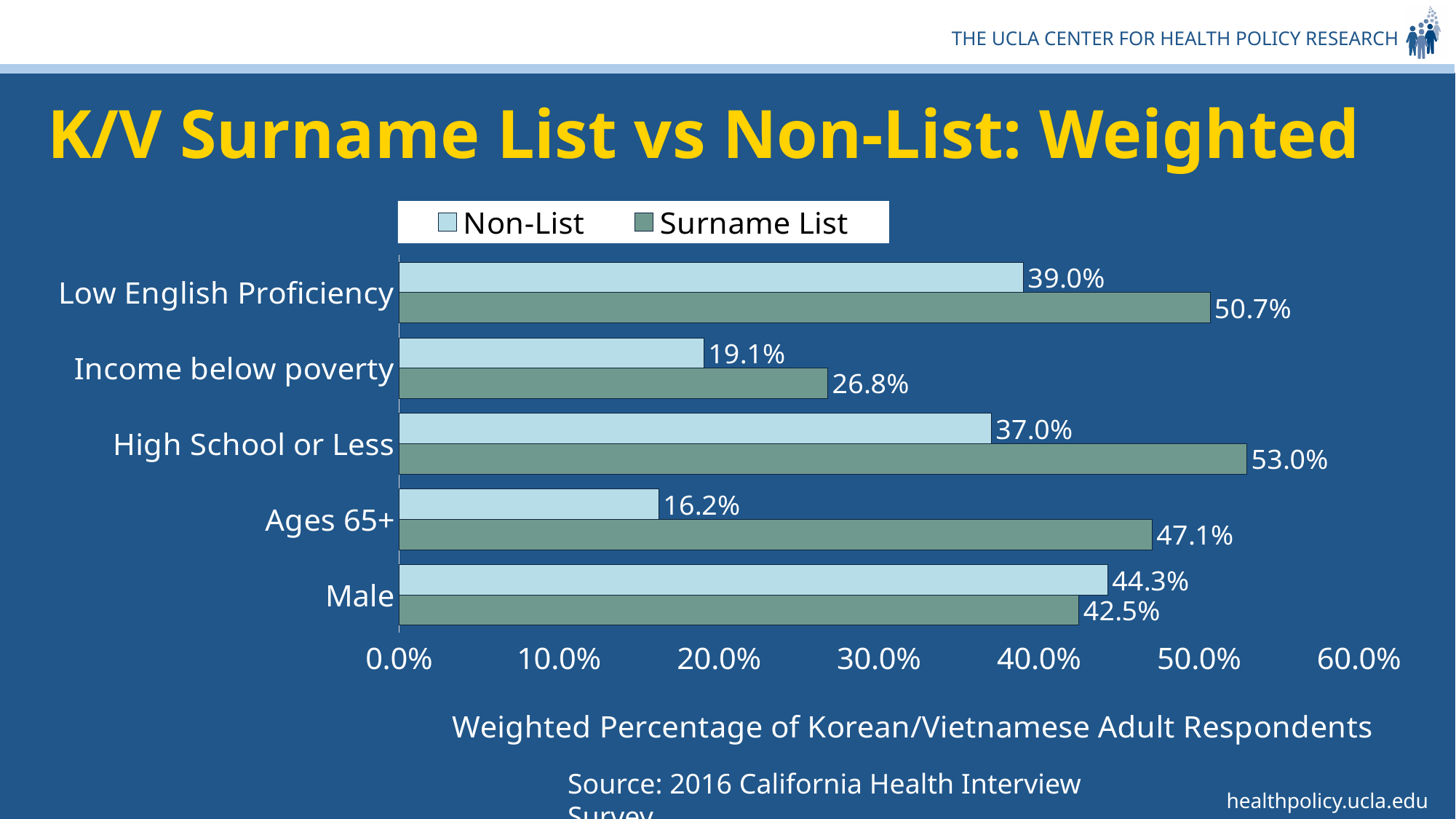
For Male, which series has the larger value, Non-List or Surname List? Non-List What is the Non-List value for Income below poverty? 19.1% What is the difference between the Surname List and Non-List values for Ages 65+? 30.9% How many series does the legend list? 2 What is the x-axis label of the chart? Weighted Percentage of Korean/Vietnamese Adult Respondents What is the Non-List value for Ages 65+? 16.2% How many categories are shown on the chart? 5 Is the Surname List value for Income below poverty greater or less than 30.0%? less Which category has the lowest Non-List value? Ages 65+ Which category has the highest Surname List value? High School or Less What kind of chart is shown on the slide? Bar chart What is the Surname List value for Low English Proficiency? 50.7%